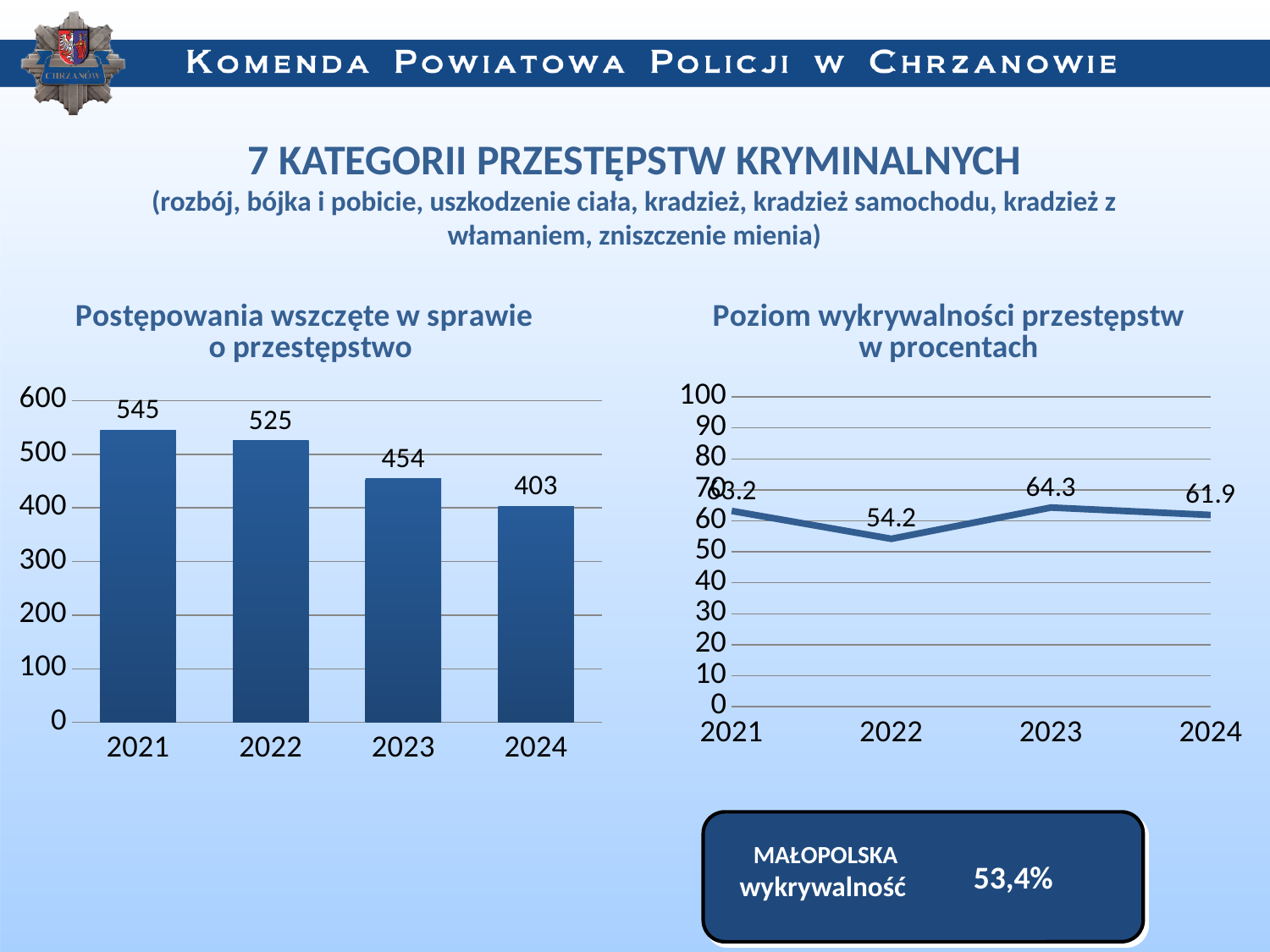
In the chart titled "Poziom wykrywalności przestępstw w procentach", which year has the lowest value? 2022 In the chart titled "Postępowania wszczęte w sprawie o przestępstwo", which year has the highest value? 2021 What kind of chart is the one titled "Poziom wykrywalności przestępstw w procentach"? line chart In the chart titled "Postępowania wszczęte w sprawie o przestępstwo", what is the difference between the values for 2021 and 2024? 142 In the chart titled "Postępowania wszczęte w sprawie o przestępstwo", what is the value for 2024? 403 In the chart titled "Poziom wykrywalności przestępstw w procentach", is the value for 2021 greater or less than 60? greater What kind of chart is the one titled "Postępowania wszczęte w sprawie o przestępstwo"? bar chart In the chart titled "Postępowania wszczęte w sprawie o przestępstwo", what is the value for 2021? 545 In the chart titled "Poziom wykrywalności przestępstw w procentach", what is the value for 2023? 64.3 In the chart titled "Poziom wykrywalności przestępstw w procentach", what is the value for 2022? 54.2 In the chart titled "Postępowania wszczęte w sprawie o przestępstwo", which year has the lowest value? 2024 In the chart titled "Postępowania wszczęte w sprawie o przestępstwo", do the values rise or fall from 2021 to 2024? fall